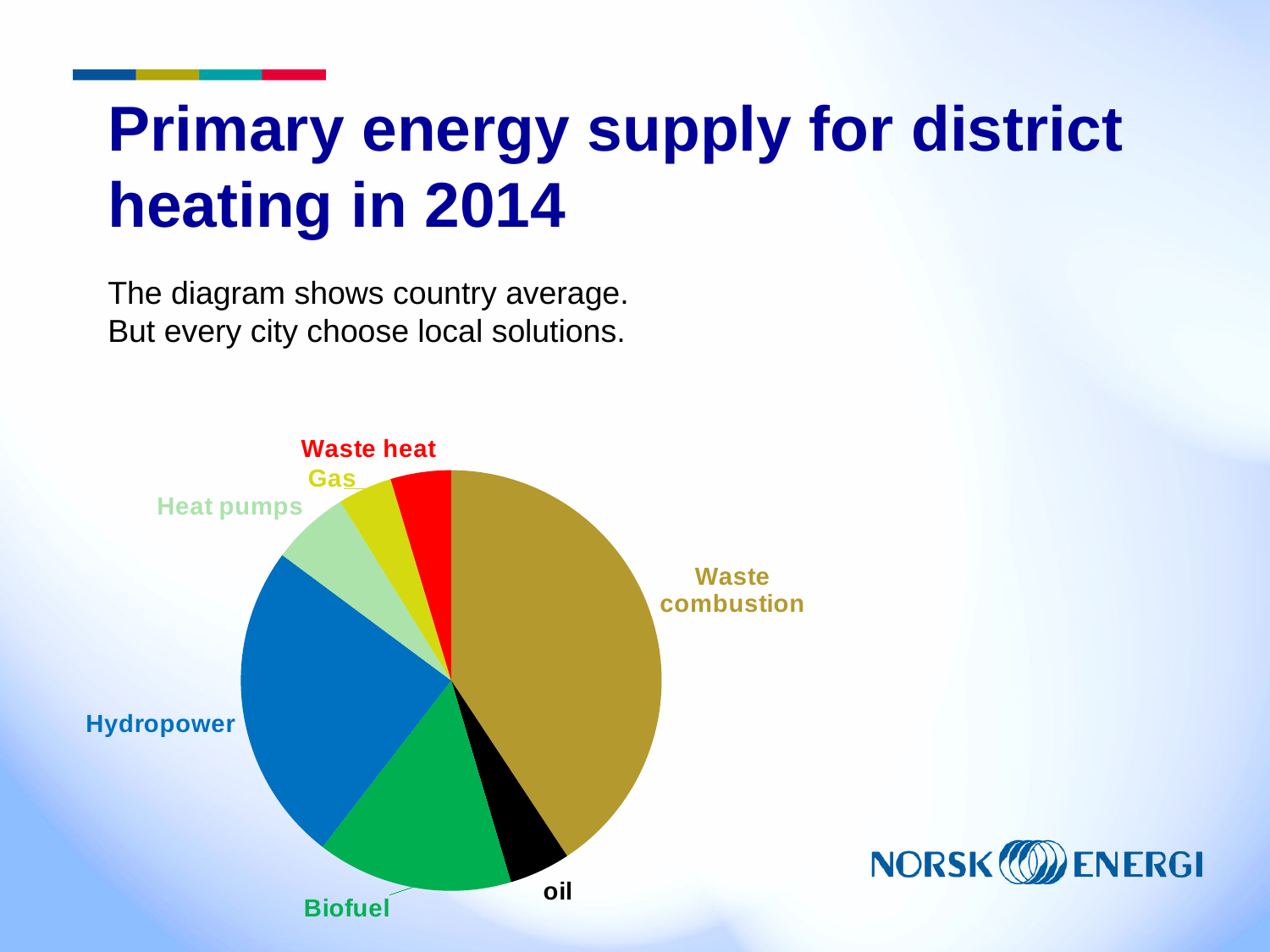
What kind of chart is shown on the slide? pie chart Which slice is larger, Biofuel or oil? Biofuel What is the title of the slide containing the pie chart? Primary energy supply for district heating in 2014 How many slices does the pie chart have? 7 What colour is the Hydropower slice in the pie chart? blue Which slice is larger, Waste combustion or Hydropower? Waste combustion Which slice is larger, Heat pumps or Gas? Heat pumps Which energy source has the largest slice of the pie chart? Waste combustion